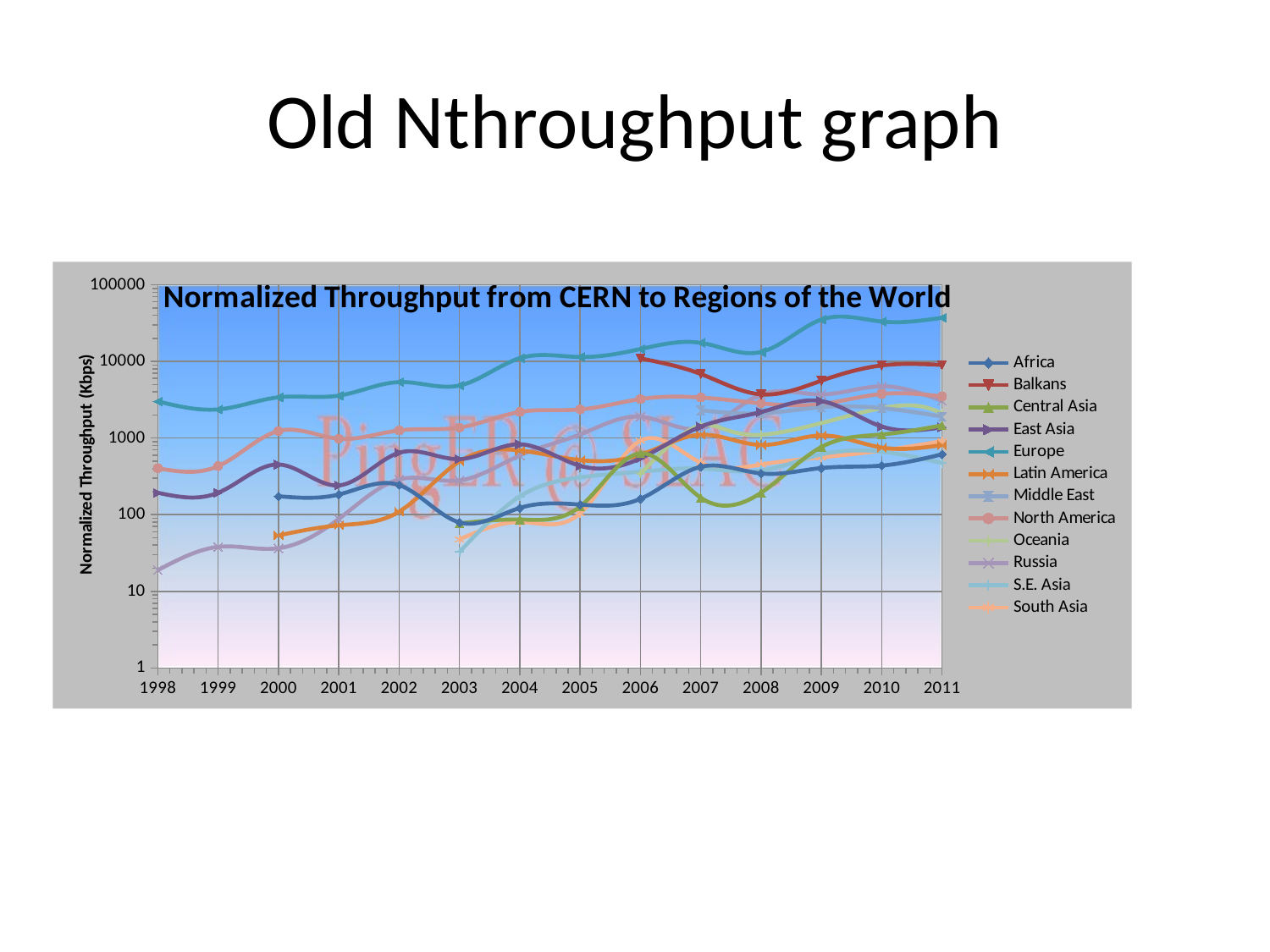
What is the label of the y axis? Normalized Throughput (Kbps) What is the title of the chart? Normalized Throughput from CERN to Regions of the World Is the value for Russia in 1998 greater or less than 100? less How many years are shown along the x axis? 14 Does the Europe series generally rise or fall from 1998 to 2011? rise Which region has the highest normalized throughput in 2011? Europe Is the value for Africa in 2003 greater or less than 100? less What kind of chart is shown on the slide? Line chart How many series does the legend list? 12 Is the value for Europe in 2011 greater or less than 10000? greater Which region has the lowest normalized throughput in 1998? Russia In 2011, which is larger, the value for Europe or the value for Africa? Europe